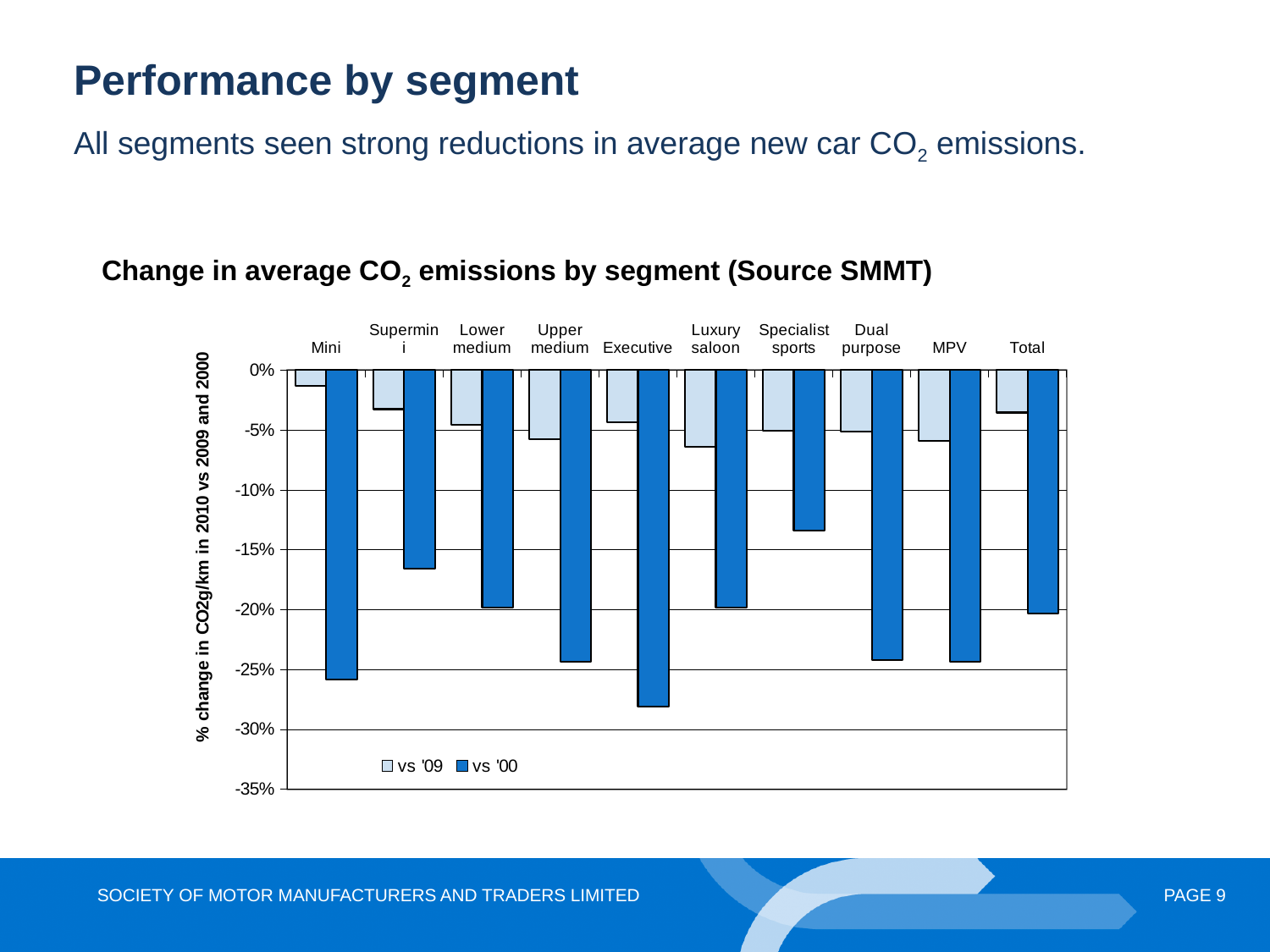
What type of chart is shown on the slide? bar chart How many series does the legend list? 2 Which segment shows the smallest reduction in the vs '00 series? Specialist sports Is the vs '00 value for Supermini greater or less than -20%? greater Is the vs '00 value for Specialist sports greater or less than -15%? greater Which shows a larger reduction in the vs '00 series, Mini or Supermini? Mini How many segment categories are plotted along the x axis? 10 Which segment shows the largest reduction in the vs '00 series? Executive Is the vs '00 value for Executive greater or less than -25%? less What are the two series named in the legend? vs '09 and vs '00 Which segment shows the smallest reduction in the vs '09 series? Mini